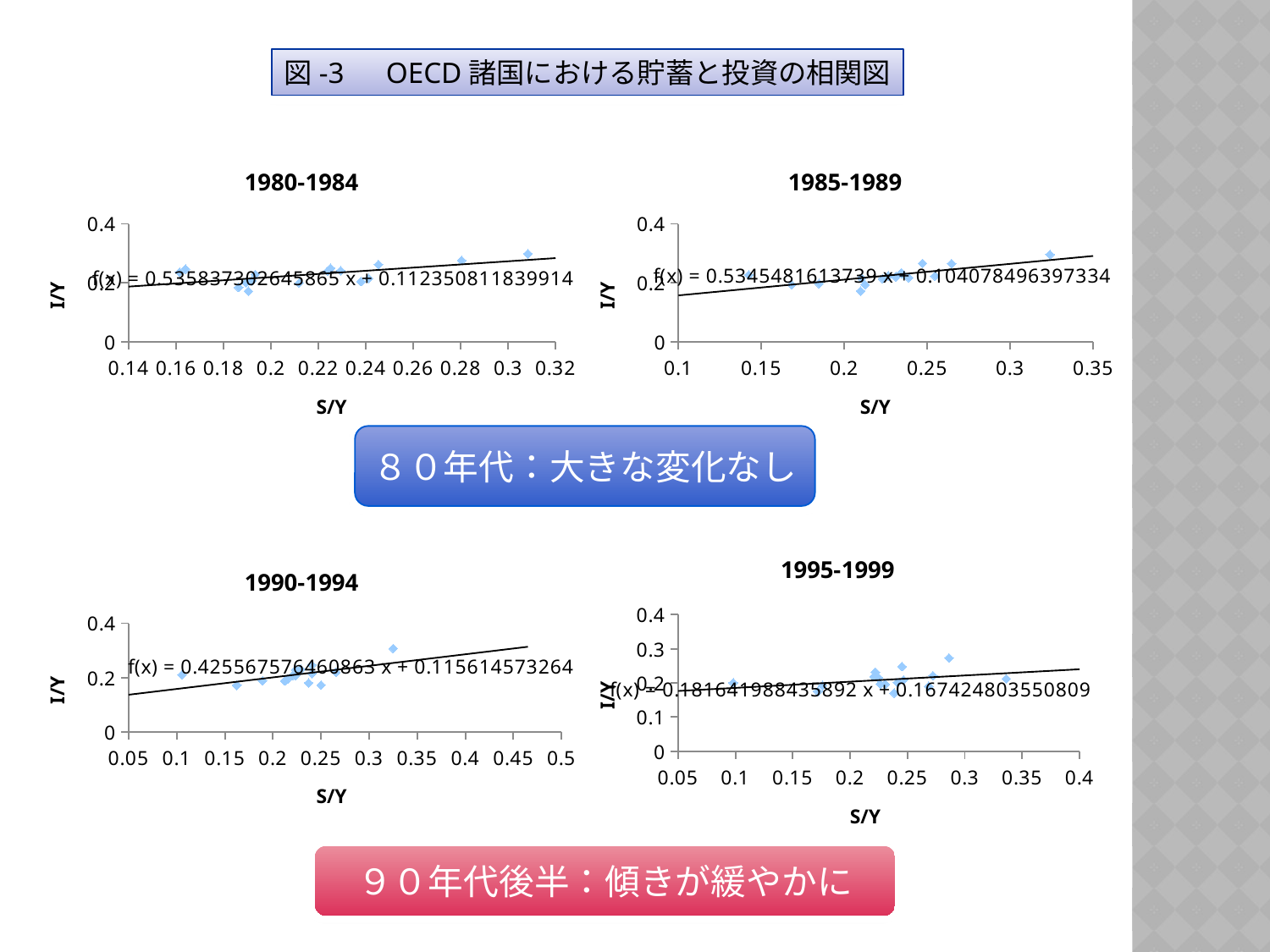
In the 1990-1994 chart, what is the intercept of the fitted line f(x)? 0.115614573264 Is the slope of the fitted line in the 1990-1994 chart larger or smaller than the slope in the 1985-1989 chart? smaller What kind of chart is the 1980-1984 chart? scatter chart What is the label of the horizontal axis in the 1990-1994 chart? S/Y How many charts are shown on the slide? 4 In the 1985-1989 chart, what is the slope of the fitted line f(x)? 0.5345481613739 In the 1980-1984 chart, what is the intercept of the fitted line f(x)? 0.112350811839914 Which of the four charts has the fitted line with the smallest slope? 1995-1999 In the 1995-1999 chart, what is the intercept of the fitted line f(x)? 0.167424803550809 In the 1995-1999 chart, does the fitted line rise or fall as S/Y increases? rise In the 1980-1984 chart, what is the slope of the fitted line f(x)? 0.535837302645865 In the 1995-1999 chart, what is the slope of the fitted line f(x)? 0.181641988435892